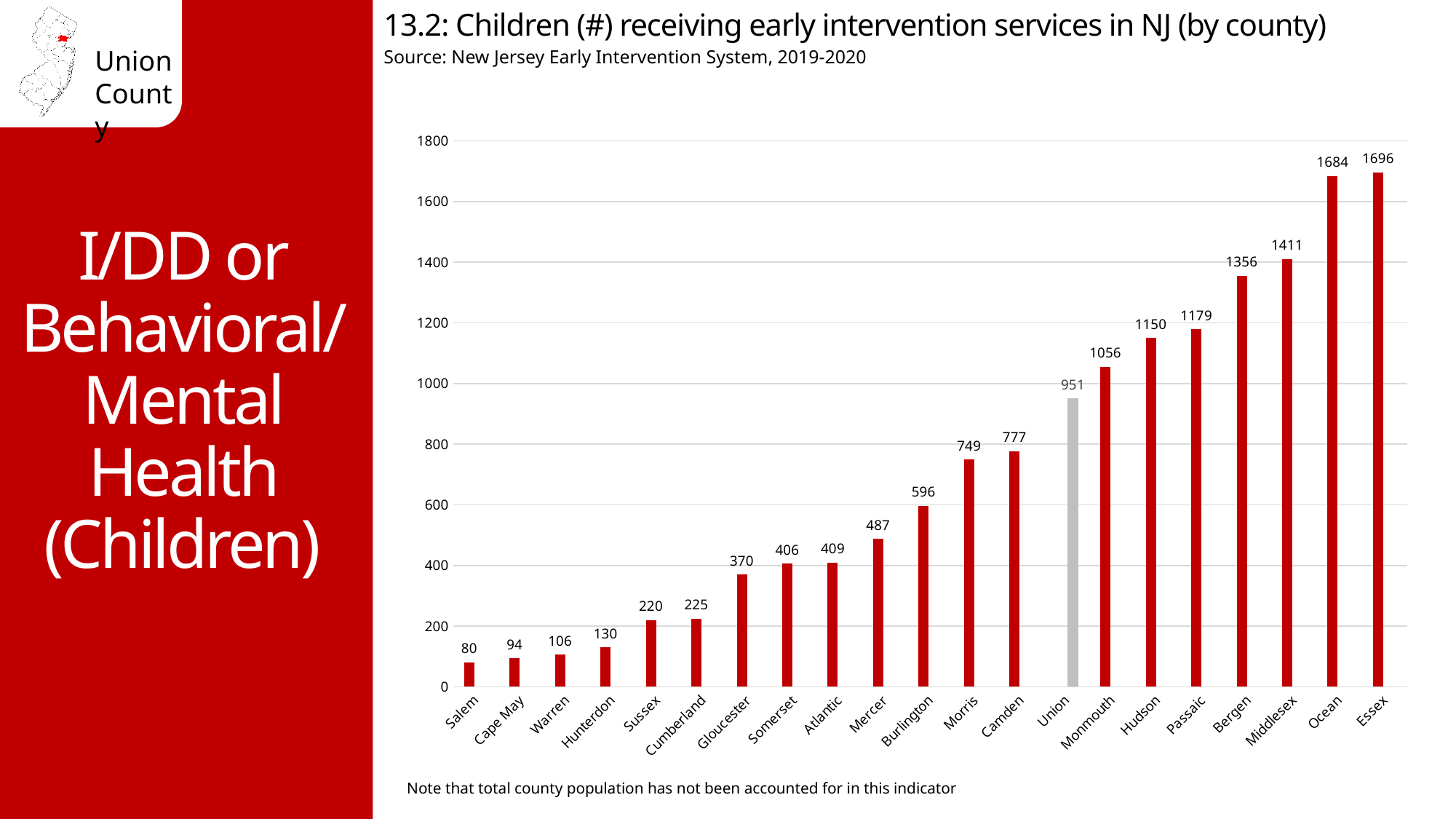
Do the values rise or fall moving from left to right along the x axis? Rise How many children received early intervention services in Union County? 951 Is the value for Bergen greater or less than 1200? greater Which county has the lowest number of children receiving early intervention services? Salem What type of chart is shown on the slide? Bar chart What is the difference between the values for Ocean and Union? 733 Which county has a larger value, Morris or Camden? Camden Which county's bar is shown in grey instead of red? Union What is the value shown for Hunterdon County? 130 What is the value shown for Essex County? 1696 Which county has the highest number of children receiving early intervention services? Essex How many counties are shown on the chart? 21